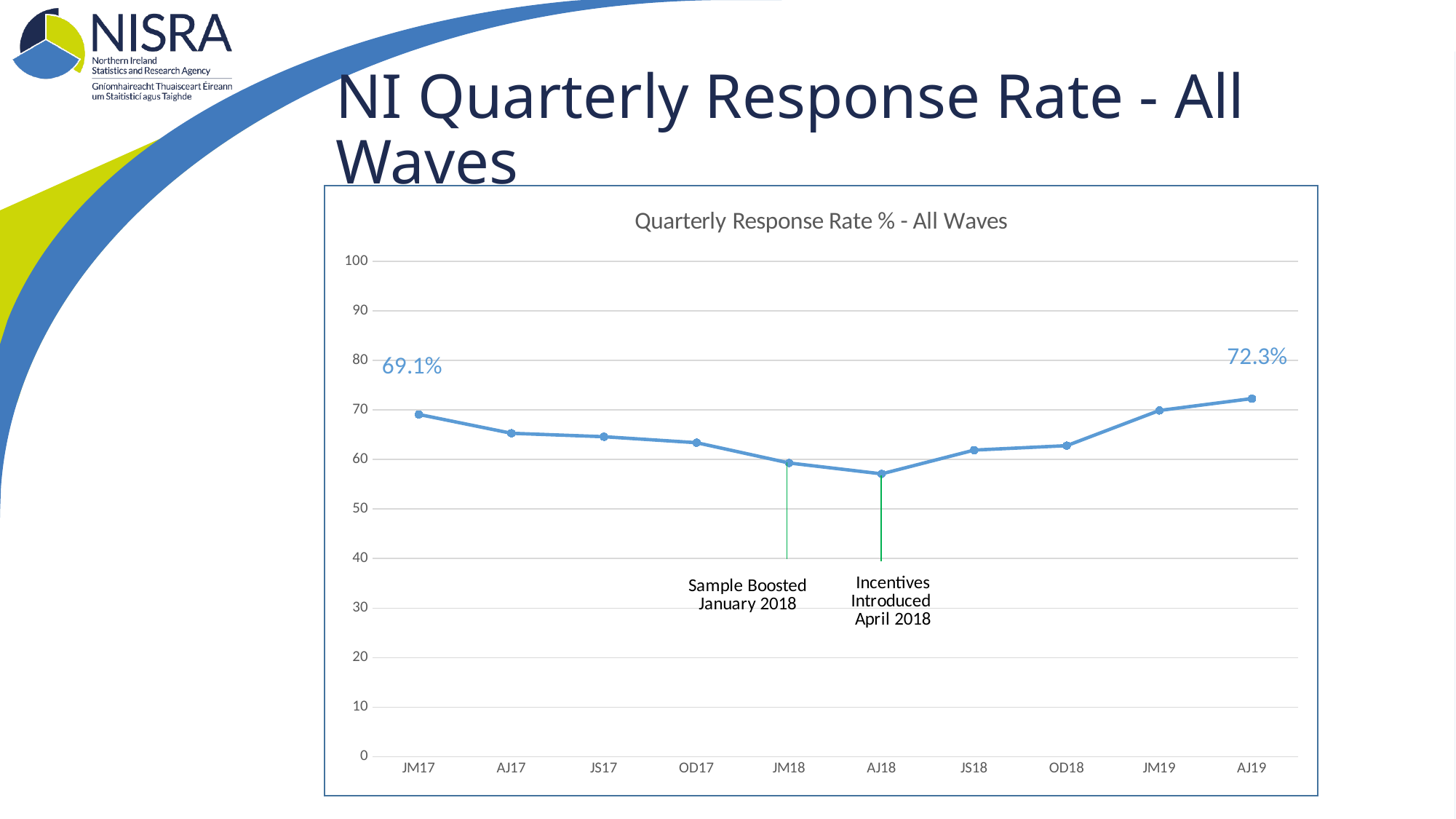
Which quarter has the highest response rate? AJ19 Do the values rise or fall from JM17 to AJ18? fall Is the value for JM19 greater or less than 60? greater What is the response rate for JM17? 69.1% Is the value for AJ18 greater or less than 60? less At which quarter is the 'Incentives Introduced April 2018' annotation placed? AJ18 By how many percentage points does the AJ19 response rate exceed the JM17 response rate? 3.2 What is the response rate for AJ19? 72.3% What kind of chart is shown? Line chart Which is larger, the value for AJ17 or the value for JM18? AJ17 How many quarters are plotted on the x axis? 10 Which quarter has the lowest response rate? AJ18